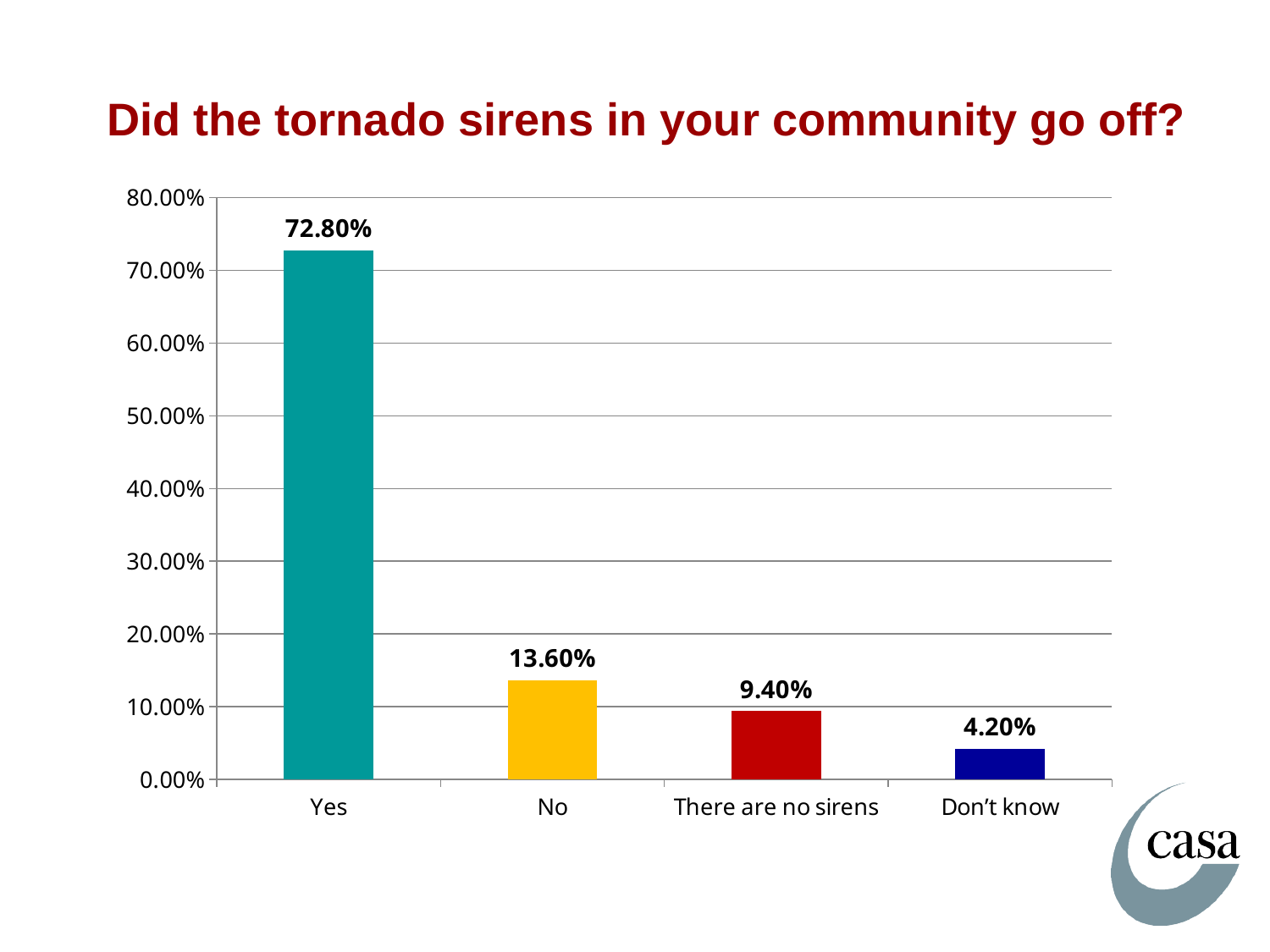
What is the value for "Don't know"? 4.20% What is the title of the chart? Did the tornado sirens in your community go off? What kind of chart is shown on the slide? Bar chart How many response categories are shown on the x axis? 4 What is the difference between the "No" and "There are no sirens" values? 4.20% What is the difference between the "Yes" and "No" values? 59.20% Which response category has the lowest value? Don't know Which response category has the highest value? Yes Which is larger, the value for "No" or the value for "There are no sirens"? No What is the value for "There are no sirens"? 9.40% What percentage of respondents answered "Yes"? 72.80% Is the value for "Yes" greater or less than 70.00%? greater